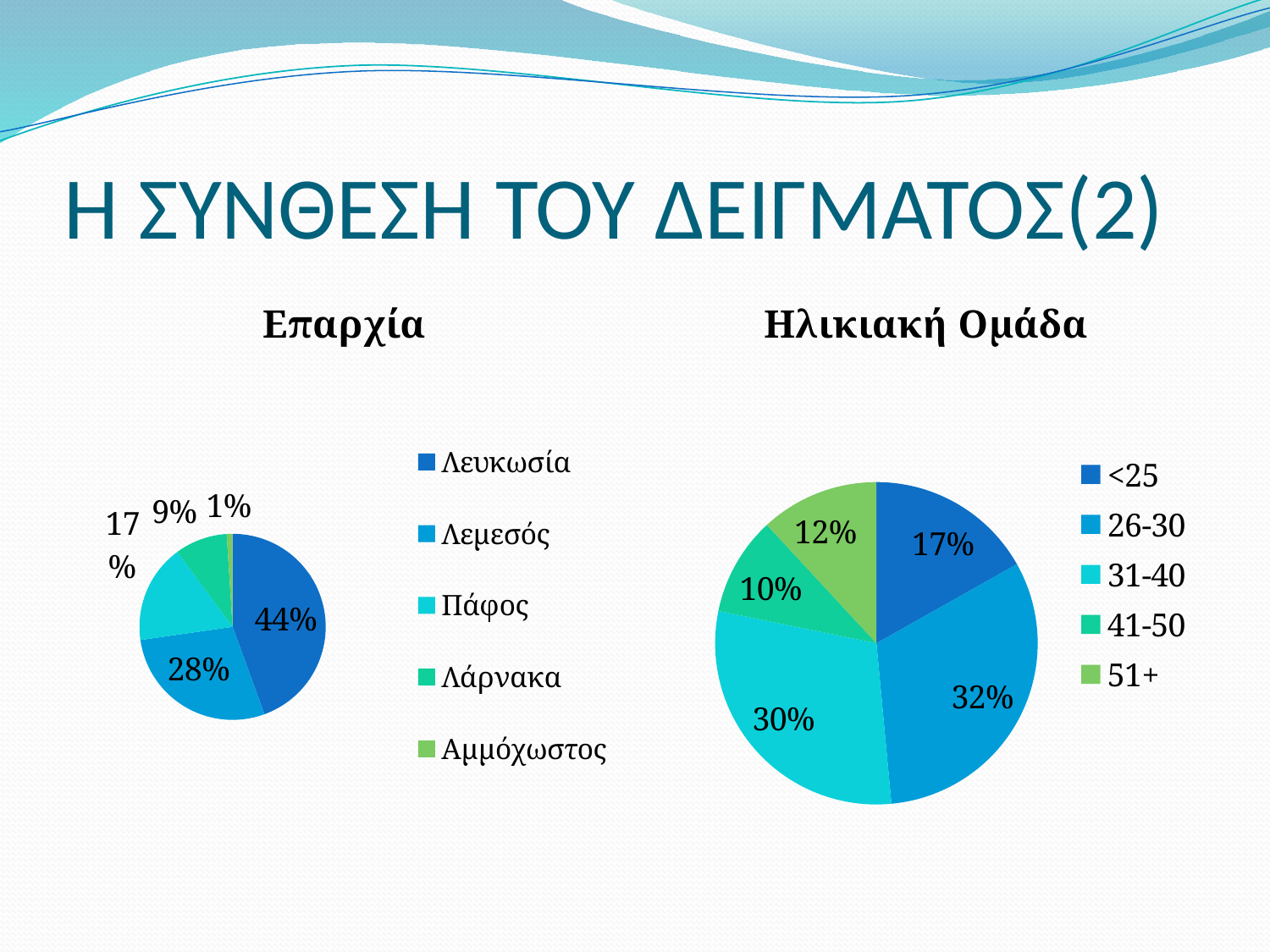
What type of chart is the "Ηλικιακή Ομάδα" chart? Pie chart In the "Ηλικιακή Ομάδα" chart, which age group has the largest share? 26-30 In the "Ηλικιακή Ομάδα" chart, what share does the 26-30 group have? 32% In the "Ηλικιακή Ομάδα" chart, what is the difference between the shares of 31-40 and 41-50? 20% In the "Επαρχία" chart, which category has the smallest share? Αμμόχωστος In the "Επαρχία" chart, what is the difference between the shares of Λευκωσία and Λεμεσός? 16% In the "Ηλικιακή Ομάδα" chart, which is larger, the share of <25 or the share of 51+? <25 In the "Επαρχία" chart, what share does Λεμεσός have? 28% In the "Ηλικιακή Ομάδα" chart, what share does the 41-50 group have? 10% In the "Επαρχία" chart, which category has the largest share? Λευκωσία In the "Επαρχία" chart, what share does Λευκωσία have? 44% In the "Επαρχία" chart, how many categories does the legend list? 5